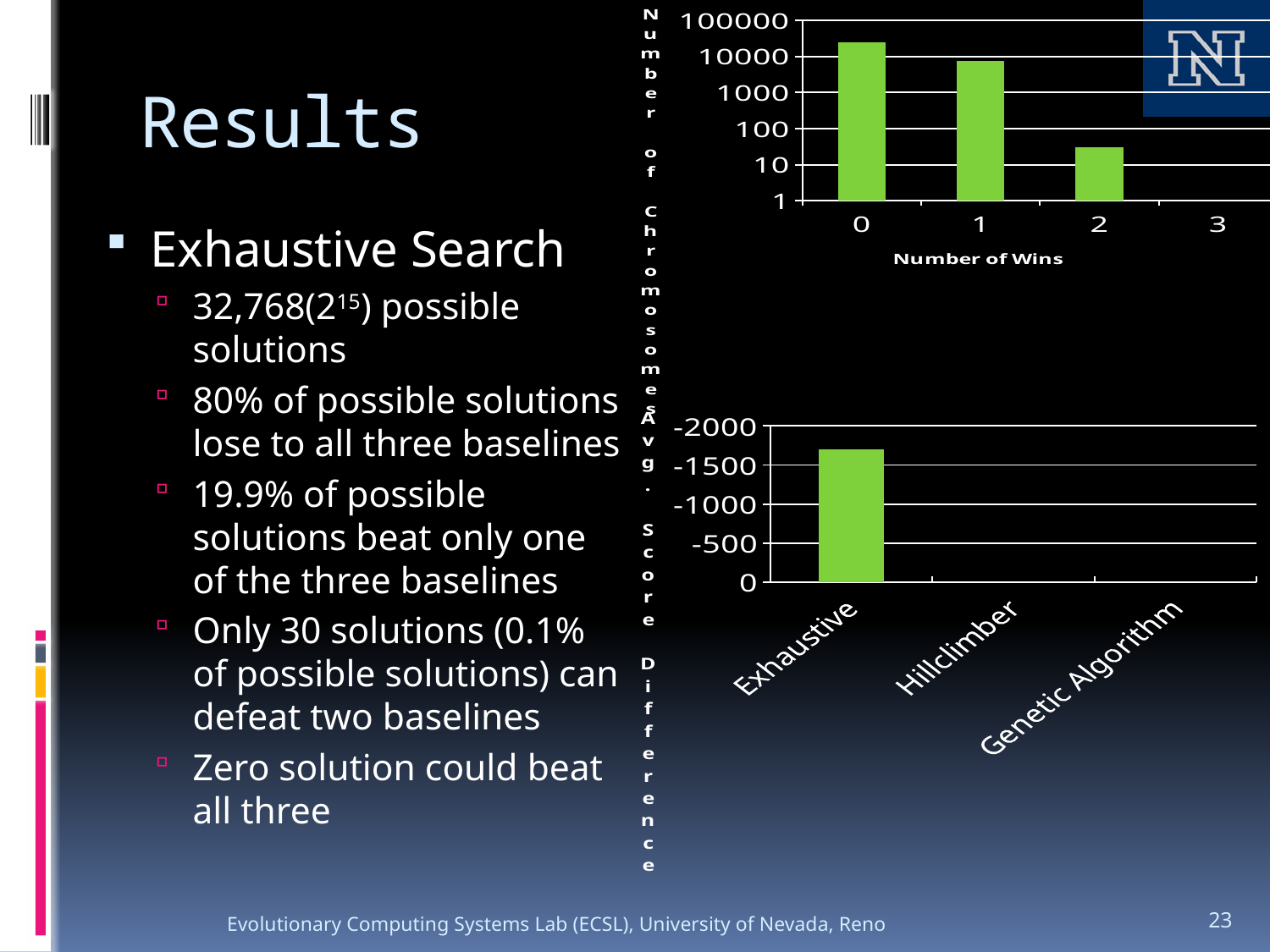
In the top chart, what is the label of the x axis? Number of Wins In the bottom chart, which category is the only one with a visible bar? Exhaustive In the top chart, what kind of chart is shown? bar chart In the top chart, is the value for 0 wins greater or less than 10000? greater In the top chart, how many categories are shown on the Number of Wins axis? 4 In the bottom chart, how many categories are shown on the x axis? 3 In the top chart, is the value for 2 wins greater or less than 100? less In the top chart, which is larger, the value for 1 win or the value for 2 wins? 1 win In the top chart, is the value for 2 wins greater or less than 10? greater In the top chart, do the bar heights rise or fall as the Number of Wins increases from 0 to 2? fall In the top chart, which Number of Wins category has the tallest bar? 0